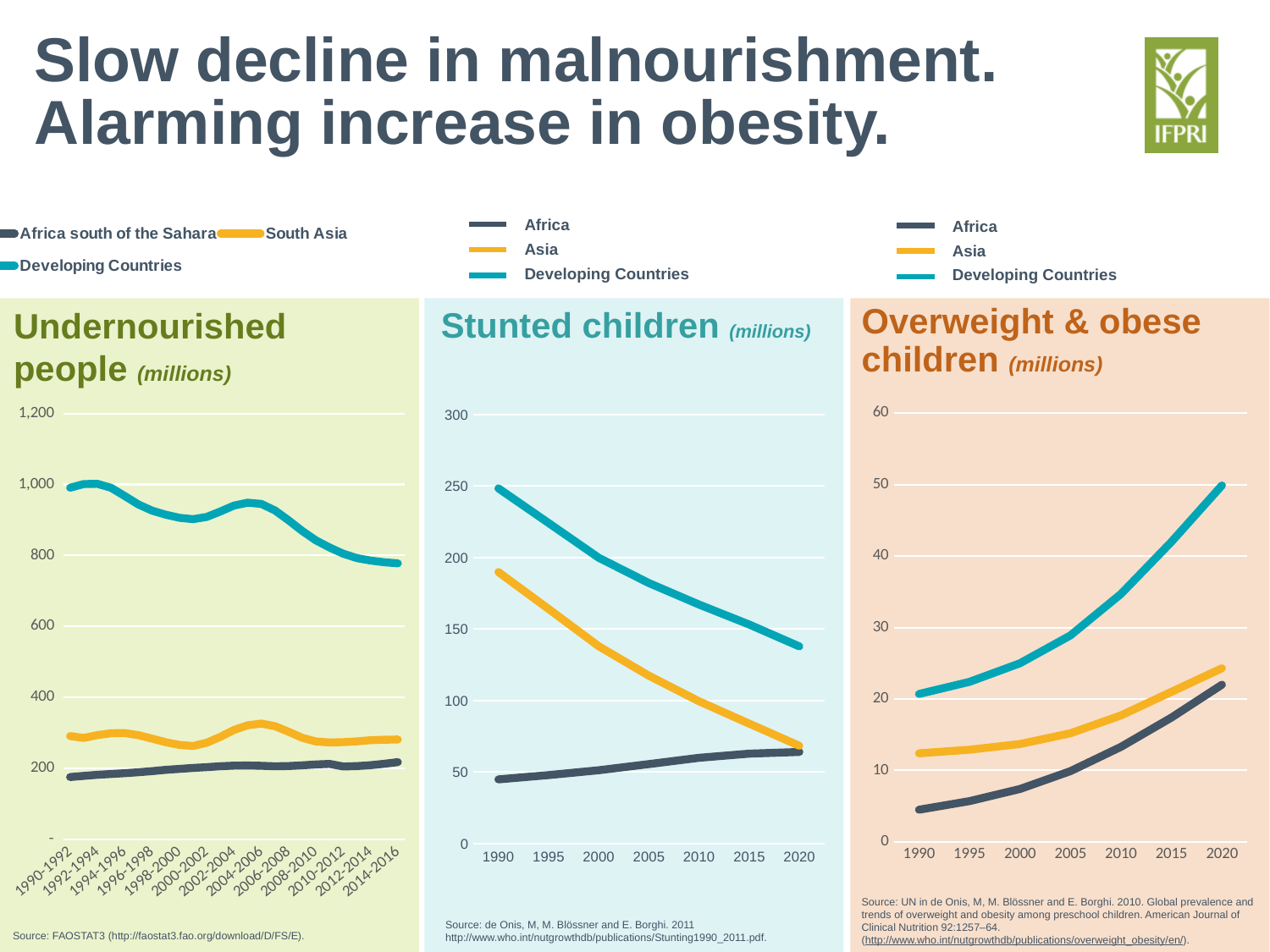
In the "Stunted children (millions)" chart, which series has the lowest value in 1990? Africa How many time periods are shown on the x axis of the "Undernourished people (millions)" chart? 13 How many series does the legend of the "Undernourished people (millions)" chart list? 3 In the "Stunted children (millions)" chart, does the Asia line rise or fall from 1990 to 2020? fall What kind of chart is the "Stunted children (millions)" chart? line chart In the "Overweight & obese children (millions)" chart, is the value for Developing Countries in 2020 greater or less than 40? greater In the "Undernourished people (millions)" chart, does the Developing Countries line rise or fall from 1990-1992 to 2014-2016? fall In the "Undernourished people (millions)" chart, is the value for Developing Countries in 1990-1992 greater or less than 800? greater In the "Undernourished people (millions)" chart, which series has the highest values? Developing Countries In the "Stunted children (millions)" chart, is the value for Developing Countries in 1990 greater or less than 200? greater In the "Overweight & obese children (millions)" chart, which is larger in 1990, Asia or Africa? Asia How many year ticks are shown on the x axis of the "Overweight & obese children (millions)" chart? 7